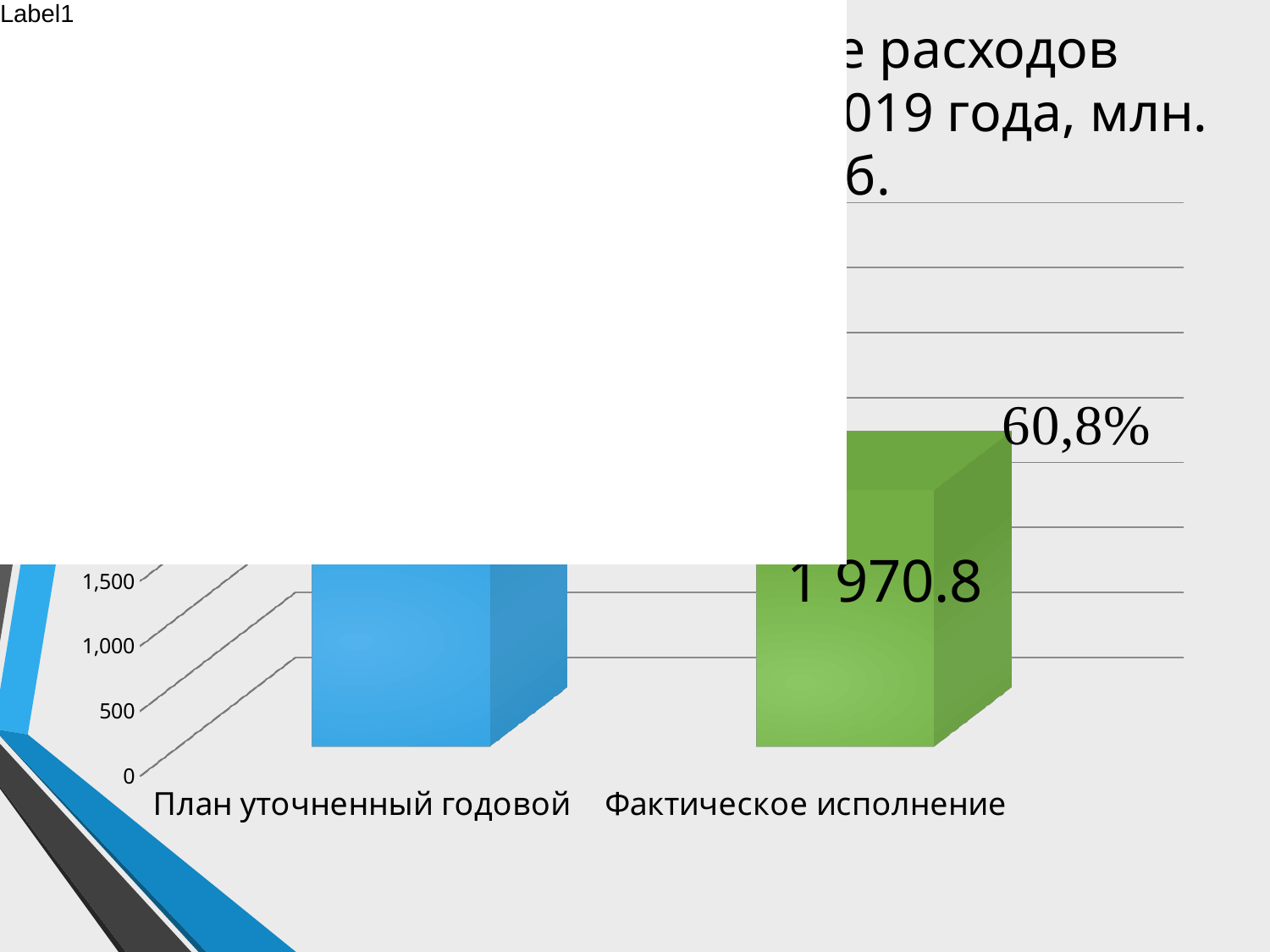
How many categories are shown on the x axis of the chart? 2 Is the value for Фактическое исполнение greater or less than 1,000? greater What colour is the bar for Фактическое исполнение? green What kind of chart is shown on the slide? bar chart What is the value shown for Фактическое исполнение? 1 970.8 What percentage is printed next to the Фактическое исполнение bar? 60,8% Is the value for Фактическое исполнение greater or less than 1,500? greater